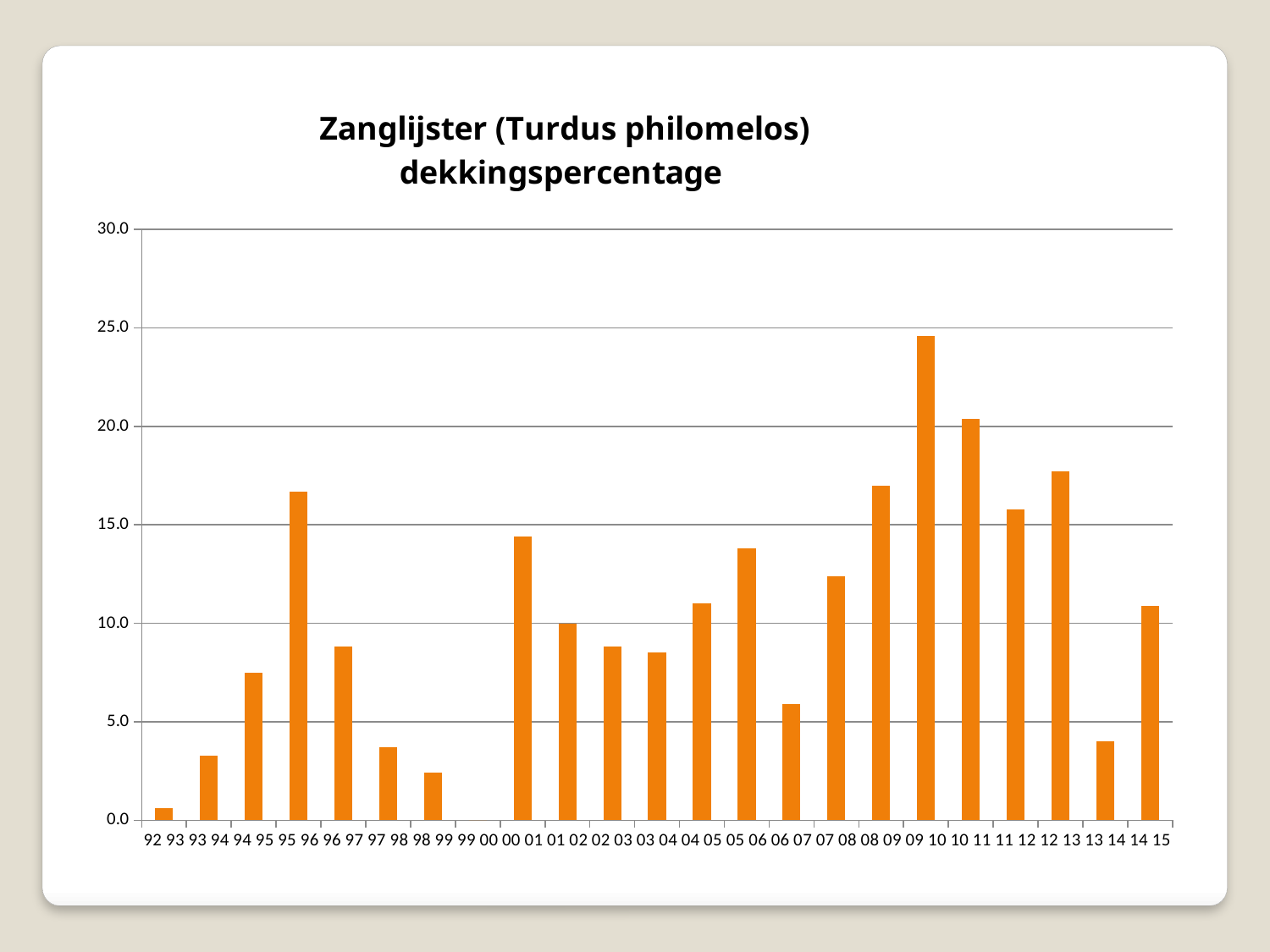
Which period has the highest dekkingspercentage? 09 10 What kind of chart is shown on the slide? bar chart Is the value for 00 01 greater or less than 15.0? less How many periods are labelled on the x axis? 23 Is the value for 07 08 greater or less than 10.0? greater Which is larger, the value for 09 10 or the value for 10 11? 09 10 What is the title of the chart? Zanglijster (Turdus philomelos) dekkingspercentage Is the value for 13 14 greater or less than 5.0? less Do the values rise or fall from 06 07 to 09 10? rise Which is larger, the value for 95 96 or the value for 96 97? 95 96